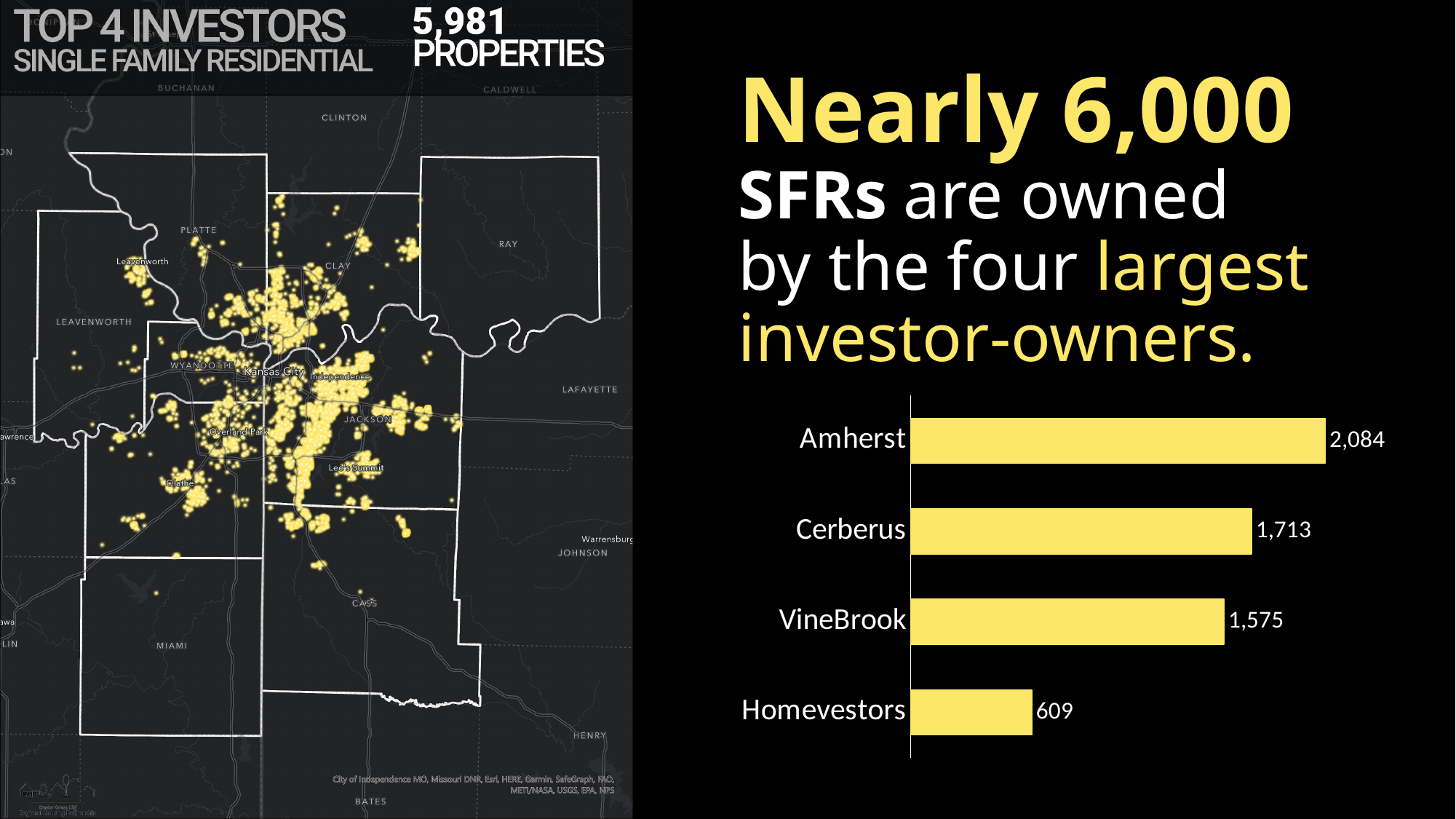
What is the difference between the values for Amherst and Cerberus? 371 What value is shown for VineBrook in the bar chart? 1,575 Which investor-owner has the lowest value in the bar chart? Homevestors How many SFRs does Amherst own according to the bar chart? 2,084 What value is shown for Homevestors in the bar chart? 609 Which investor-owner has the highest value in the bar chart? Amherst What kind of chart is used to show the investor-owner values? Bar chart What is the difference between the values for VineBrook and Homevestors? 966 What value is shown for Cerberus in the bar chart? 1,713 How many investor-owners are shown in the bar chart? 4 What is the total number of properties shown in the map header on the left? 5,981 Which has a larger value, Cerberus or VineBrook? Cerberus